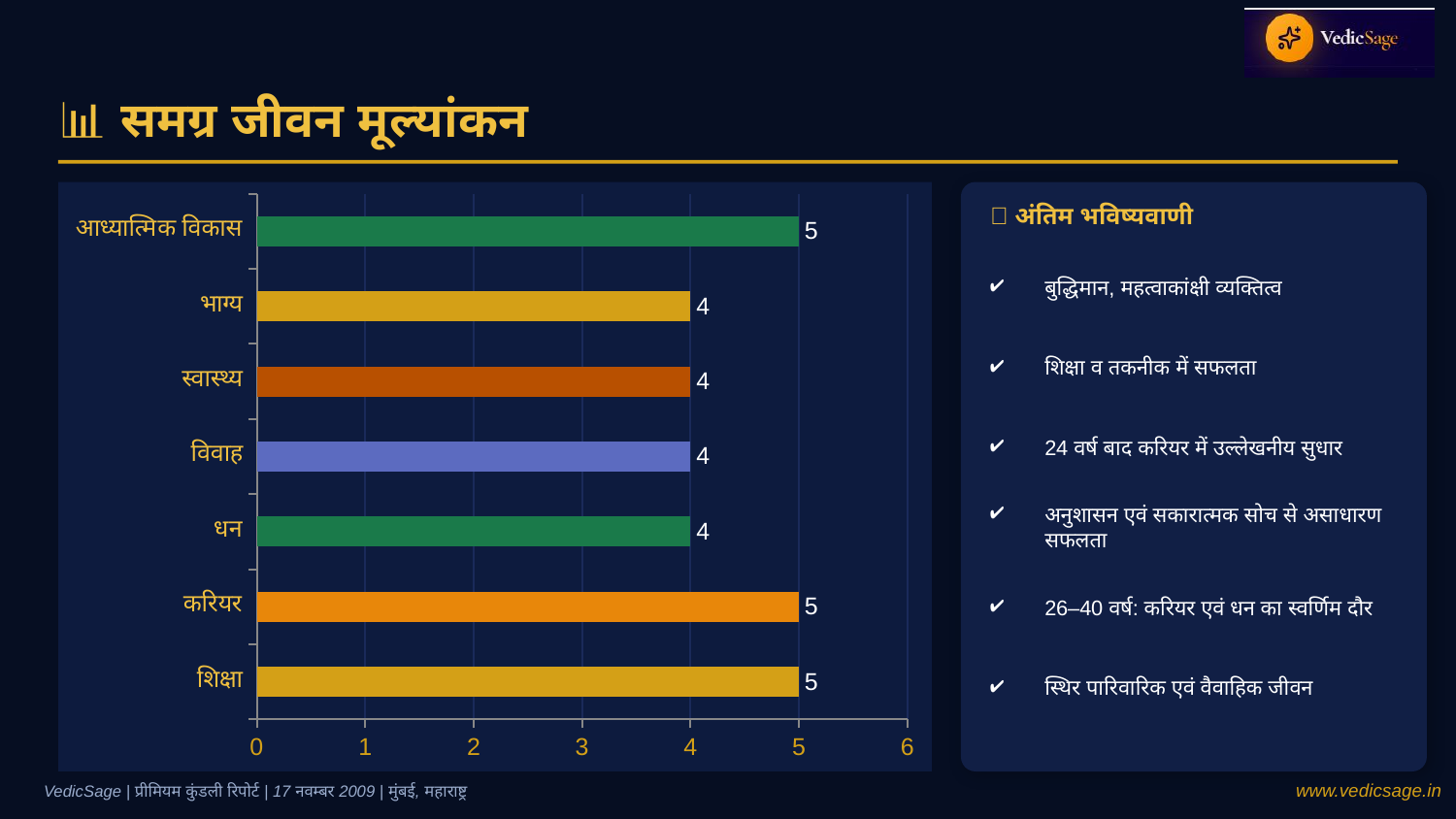
What is the title of the slide containing the chart? समग्र जीवन मूल्यांकन Is the value for भाग्य greater or less than 3? greater What is the value for आध्यात्मिक विकास? 5 What kind of chart is shown on the slide? bar chart What is the value for करियर? 5 What is the difference between the values for शिक्षा and भाग्य? 1 What is the value for शिक्षा? 5 What is the value for विवाह? 4 Which has a larger value, करियर or स्वास्थ्य? करियर What is the value for धन? 4 How many categories are shown in the chart? 7 Which has a larger value, धन or आध्यात्मिक विकास? आध्यात्मिक विकास